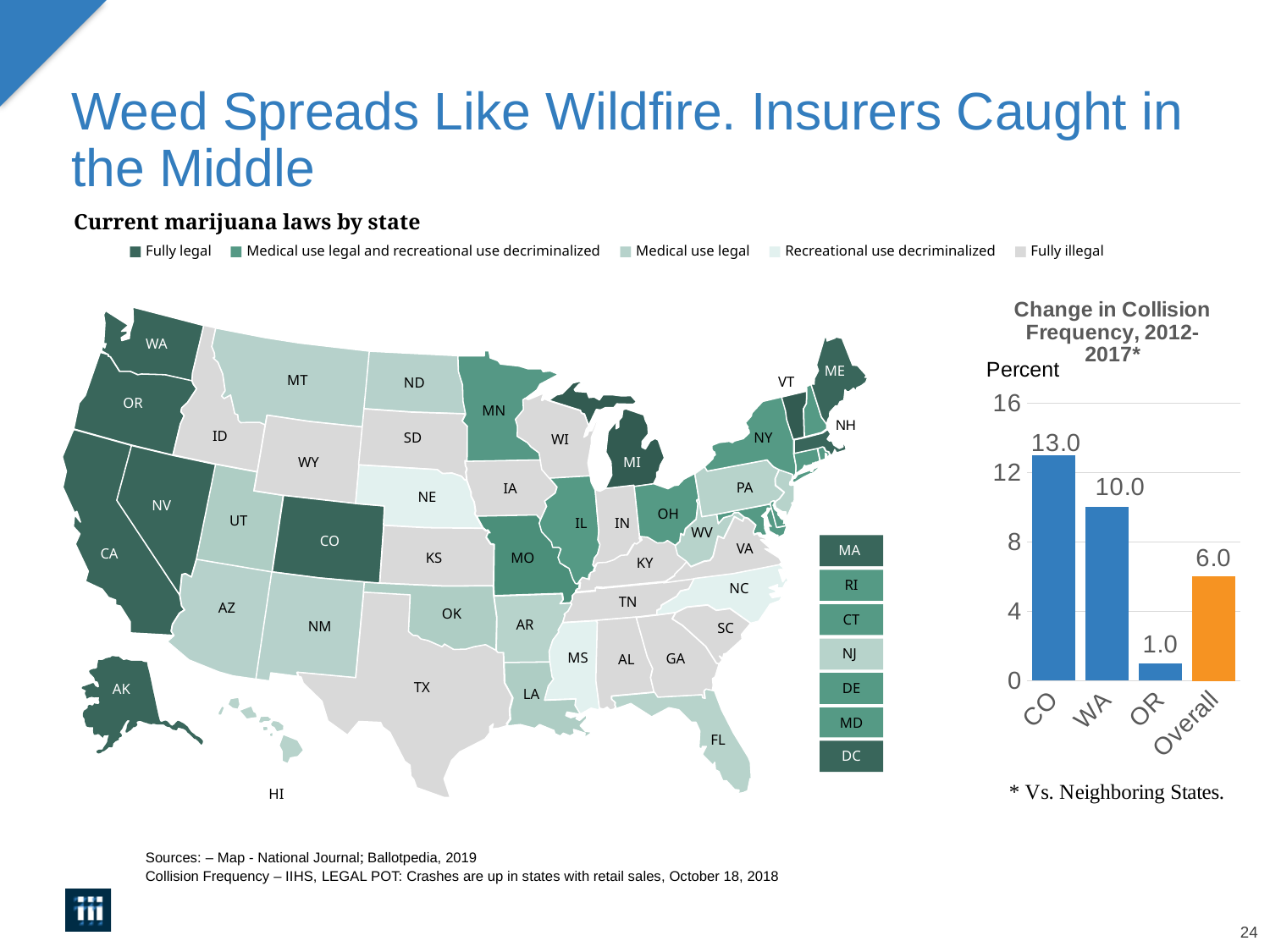
In the 'Change in Collision Frequency, 2012-2017*' chart, what is the value for CO? 13.0 In the 'Change in Collision Frequency, 2012-2017*' chart, is the value for CO greater or less than 12? greater In the 'Change in Collision Frequency, 2012-2017*' chart, what is the value for Overall? 6.0 In the 'Change in Collision Frequency, 2012-2017*' chart, which is larger, the value for WA or the value for Overall? WA What kind of chart is the 'Change in Collision Frequency, 2012-2017*' chart? bar chart In the 'Change in Collision Frequency, 2012-2017*' chart, what is the difference between the values for WA and OR? 9.0 In the 'Change in Collision Frequency, 2012-2017*' chart, what is the value for OR? 1.0 In the 'Change in Collision Frequency, 2012-2017*' chart, what is the value for WA? 10.0 How many categories are shown in the 'Change in Collision Frequency, 2012-2017*' chart? 4 In the 'Change in Collision Frequency, 2012-2017*' chart, which category has the highest value? CO In the 'Change in Collision Frequency, 2012-2017*' chart, what is the difference between the values for CO and WA? 3.0 In the 'Change in Collision Frequency, 2012-2017*' chart, which category has the lowest value? OR